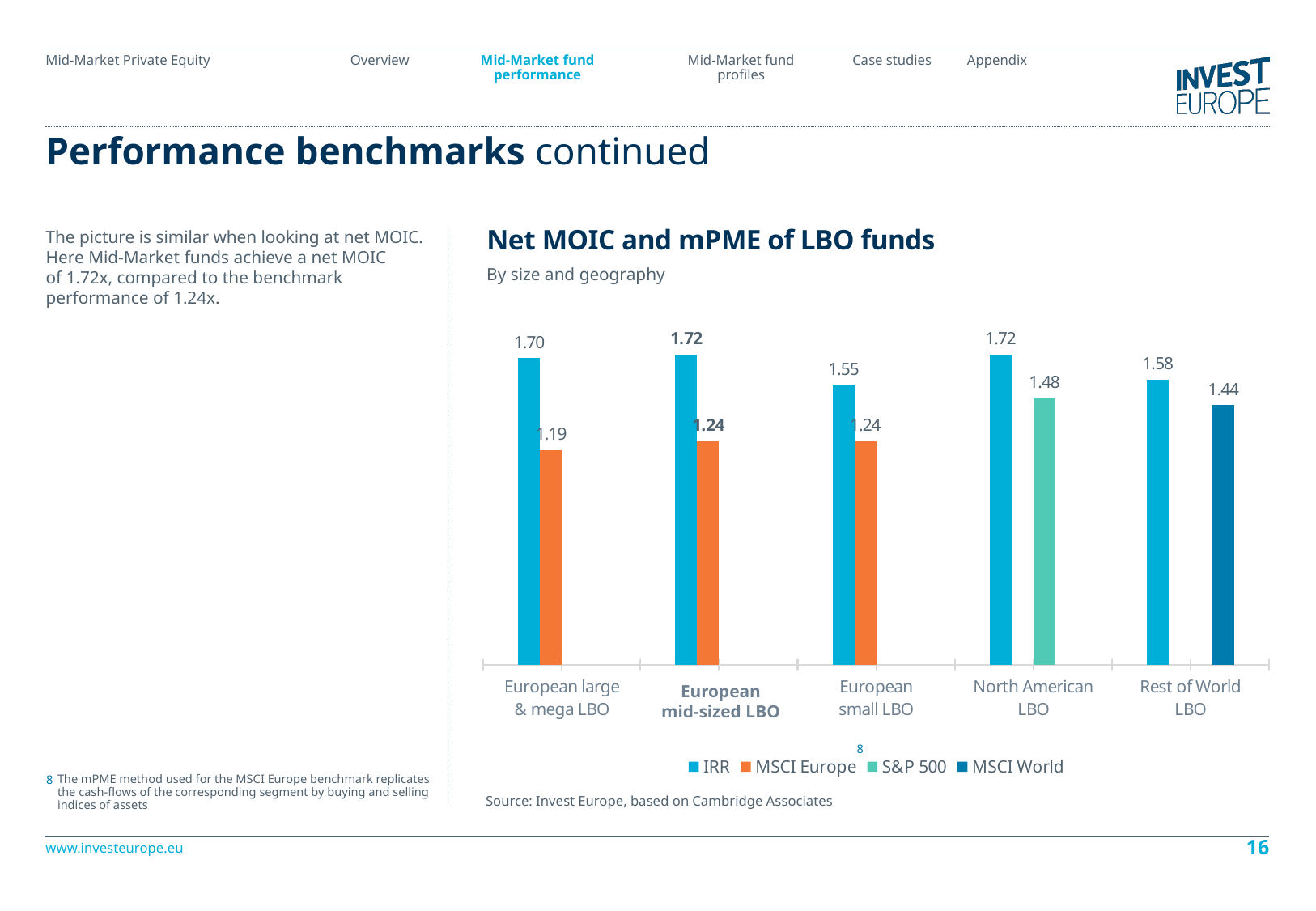
What kind of chart is shown? Bar chart How many series does the legend list? 4 What is the MSCI Europe value for European mid-sized LBO? 1.24 What is the difference between the IRR values for European large & mega LBO and European small LBO? 0.15 Which category has the lowest IRR value? European small LBO What is the IRR value for European large & mega LBO? 1.70 What is the S&P 500 value for North American LBO? 1.48 Which is larger: the IRR value for Rest of World LBO or the IRR value for European small LBO? Rest of World LBO How many categories are shown on the x axis? 5 What is the MSCI World value for Rest of World LBO? 1.44 What is the difference between the IRR and MSCI Europe values for European mid-sized LBO? 0.48 Which category has the lowest benchmark (non-IRR) value? European large & mega LBO